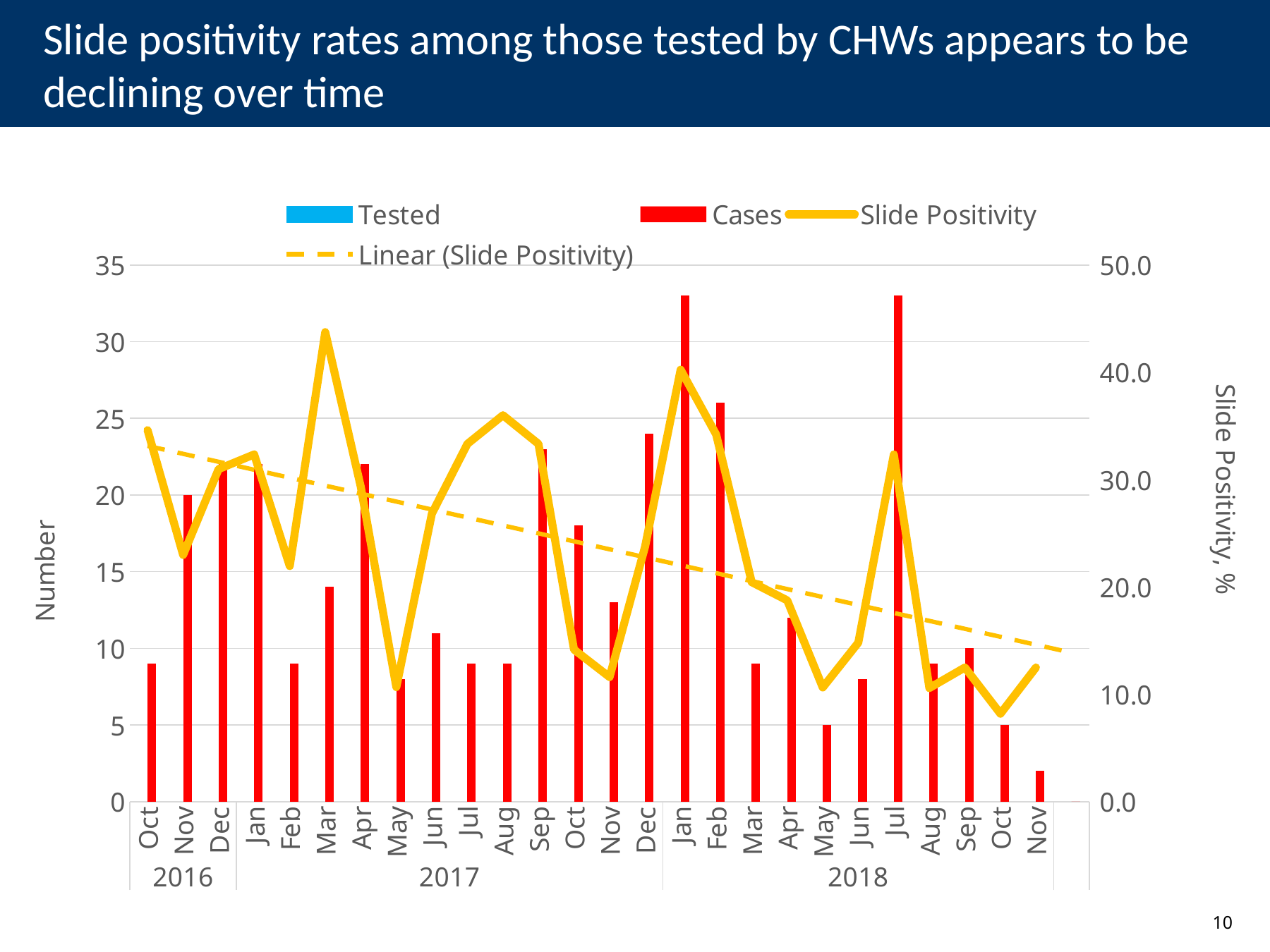
How many series does the legend list? 4 Does the dashed Linear (Slide Positivity) trend line rise or fall from left to right? Fall Is the number of Cases for May 2018 greater or less than 10? less Is the Slide Positivity value for Mar 2017 greater or less than 40.0? greater Which month has more Cases, Nov 2017 or Dec 2017? Dec 2017 Which month has the lowest number of Cases? Nov 2018 What is the label of the right-hand vertical axis? Slide Positivity, % What kind of chart is shown on the slide? A combined bar and line chart In which month does the Slide Positivity line reach its highest point? Mar 2017 Is the number of Cases for Jan 2018 greater or less than 30? greater How many months are plotted along the x axis? 26 In which month does the Slide Positivity line reach its lowest point? Oct 2018